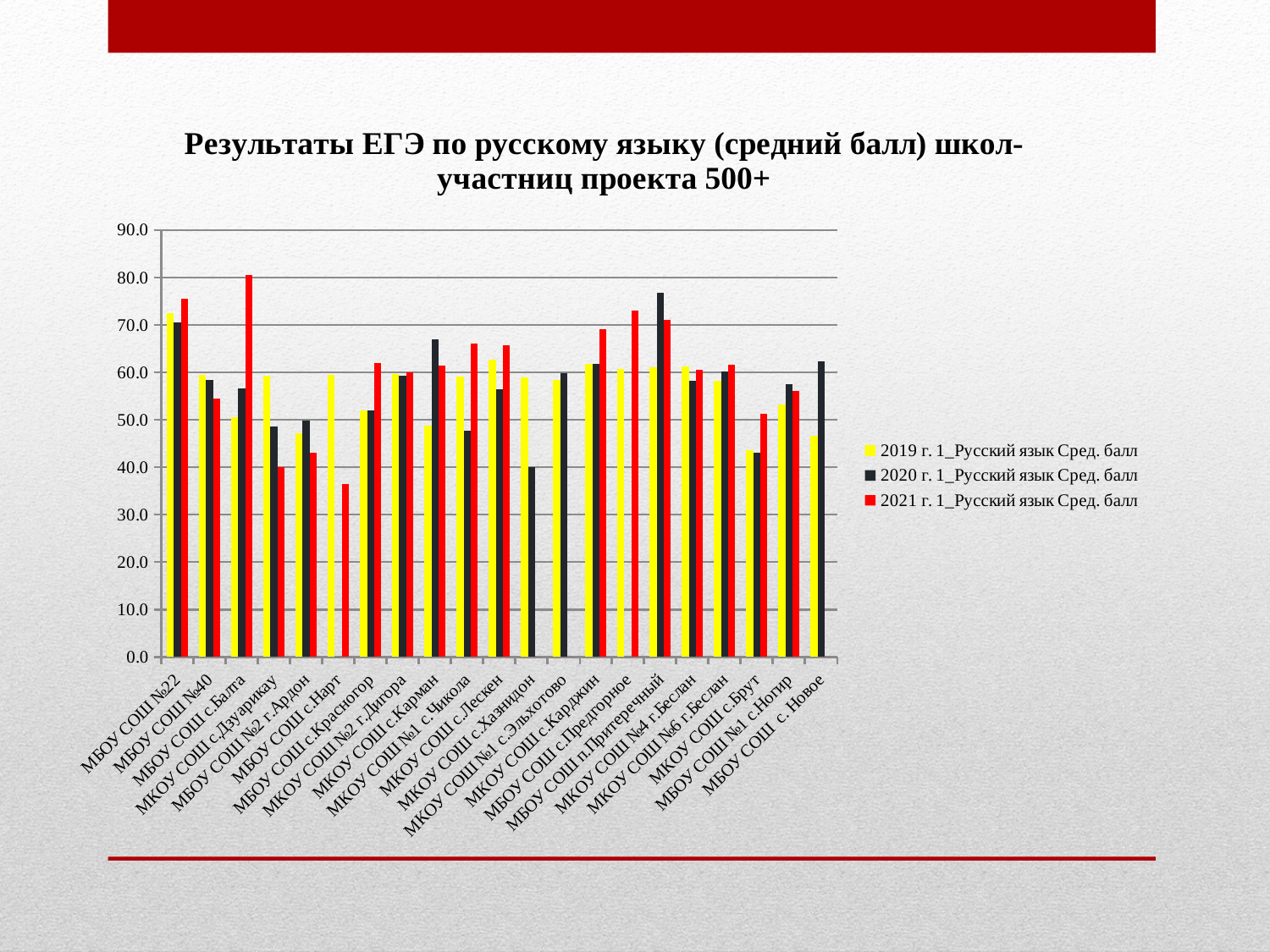
Is the 2021 г. 1_Русский язык Сред. балл value for МБОУ СОШ с.Нарт greater or less than 40.0? less For МКОУ СОШ с.Карман, which is larger: the 2019 г. value or the 2020 г. value? 2020 г. Is the 2019 г. 1_Русский язык Сред. балл value for МБОУ СОШ №22 greater or less than 70.0? greater What colour represents the 2021 г. 1_Русский язык Сред. балл series? red Which school has the highest 2020 г. 1_Русский язык Сред. балл value? МБОУ СОШ п.Притеречный How many schools are shown on the x axis? 21 Which school has the highest 2021 г. 1_Русский язык Сред. балл value? МБОУ СОШ с.Балта Is the 2021 г. 1_Русский язык Сред. балл value for МБОУ СОШ с.Балта greater or less than 70.0? greater For МБОУ СОШ с.Балта, which is larger: the 2019 г. value or the 2021 г. value? 2021 г. Which school has the lowest 2021 г. 1_Русский язык Сред. балл value? МБОУ СОШ с.Нарт What kind of chart is shown on the slide? bar chart How many series does the legend list? 3